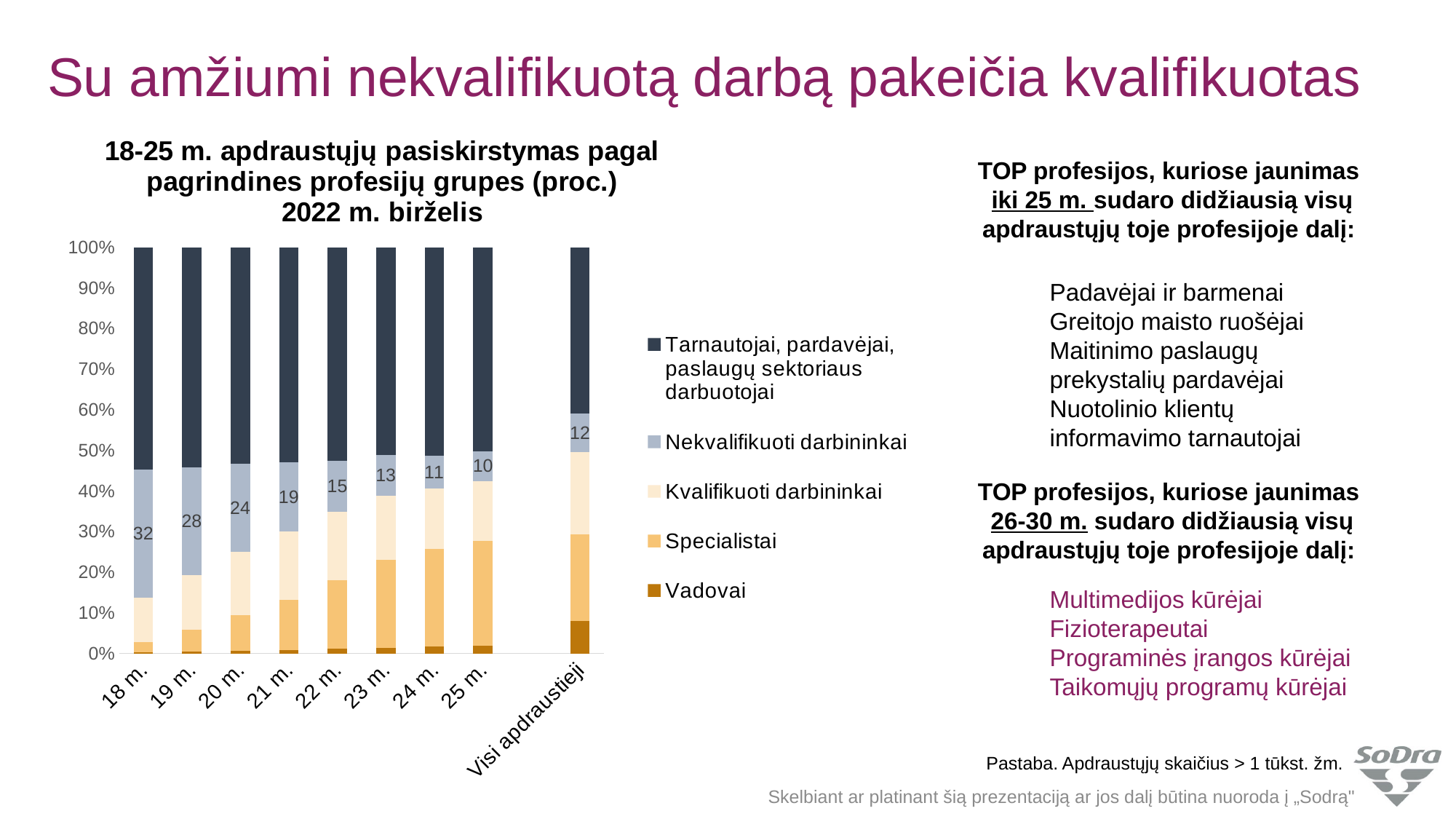
What is the value for Nekvalifikuoti darbininkai for 18 m.? 32 What is the difference between the Nekvalifikuoti darbininkai values for 18 m. and 25 m.? 22 Do the Nekvalifikuoti darbininkai values rise or fall from 18 m. to 25 m.? fall Which category has the highest value for Nekvalifikuoti darbininkai? 18 m. Which category has the lowest value for Nekvalifikuoti darbininkai? 25 m. What kind of chart is shown on the slide? stacked bar chart What is the value for Nekvalifikuoti darbininkai for Visi apdraustieji? 12 What is the value for Nekvalifikuoti darbininkai for 22 m.? 15 How many series does the legend list? 5 How many categories are shown on the x axis? 9 Which is larger, the Nekvalifikuoti darbininkai value for 20 m. or for 23 m.? 20 m. Is the Tarnautojai, pardavėjai, paslaugų sektoriaus darbuotojai share for 18 m. greater or less than 50%? greater